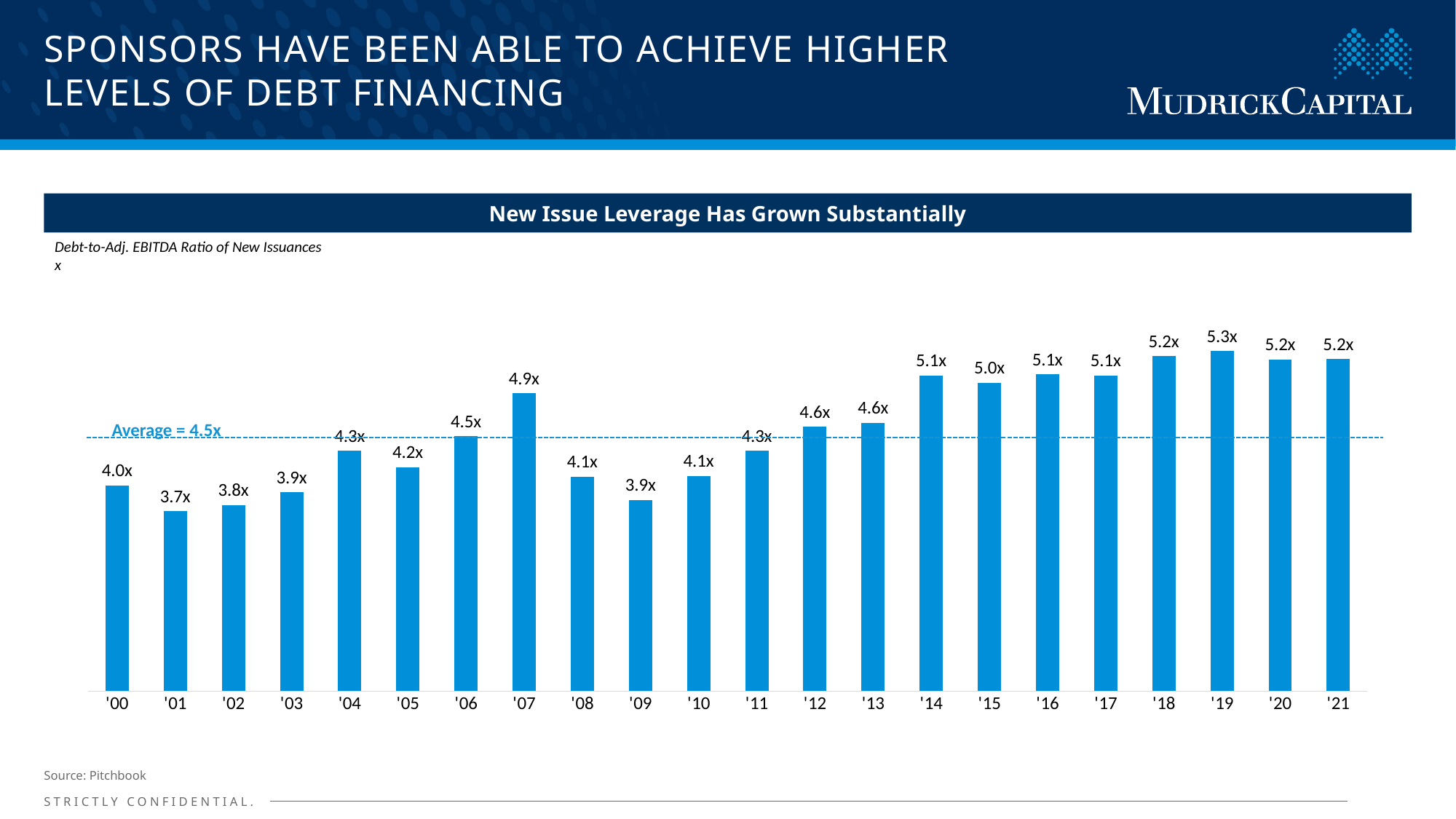
What kind of chart is shown on the slide? Bar chart Which is larger, the value for '07 or the value for '12? '07 What is the value shown for '01? 3.7x Which year has the highest Debt-to-Adj. EBITDA ratio? '19 What is the value shown for '19? 5.3x What is the difference between the values for '21 and '00? 1.2x What average value is marked by the dashed line on the chart? 4.5x How many years are shown on the x axis? 22 What is the title of the chart? New Issue Leverage Has Grown Substantially What is the Debt-to-Adj. EBITDA ratio of new issuances for '07? 4.9x Do the values generally rise or fall from '00 to '21? Rise Which year has the lowest Debt-to-Adj. EBITDA ratio? '01